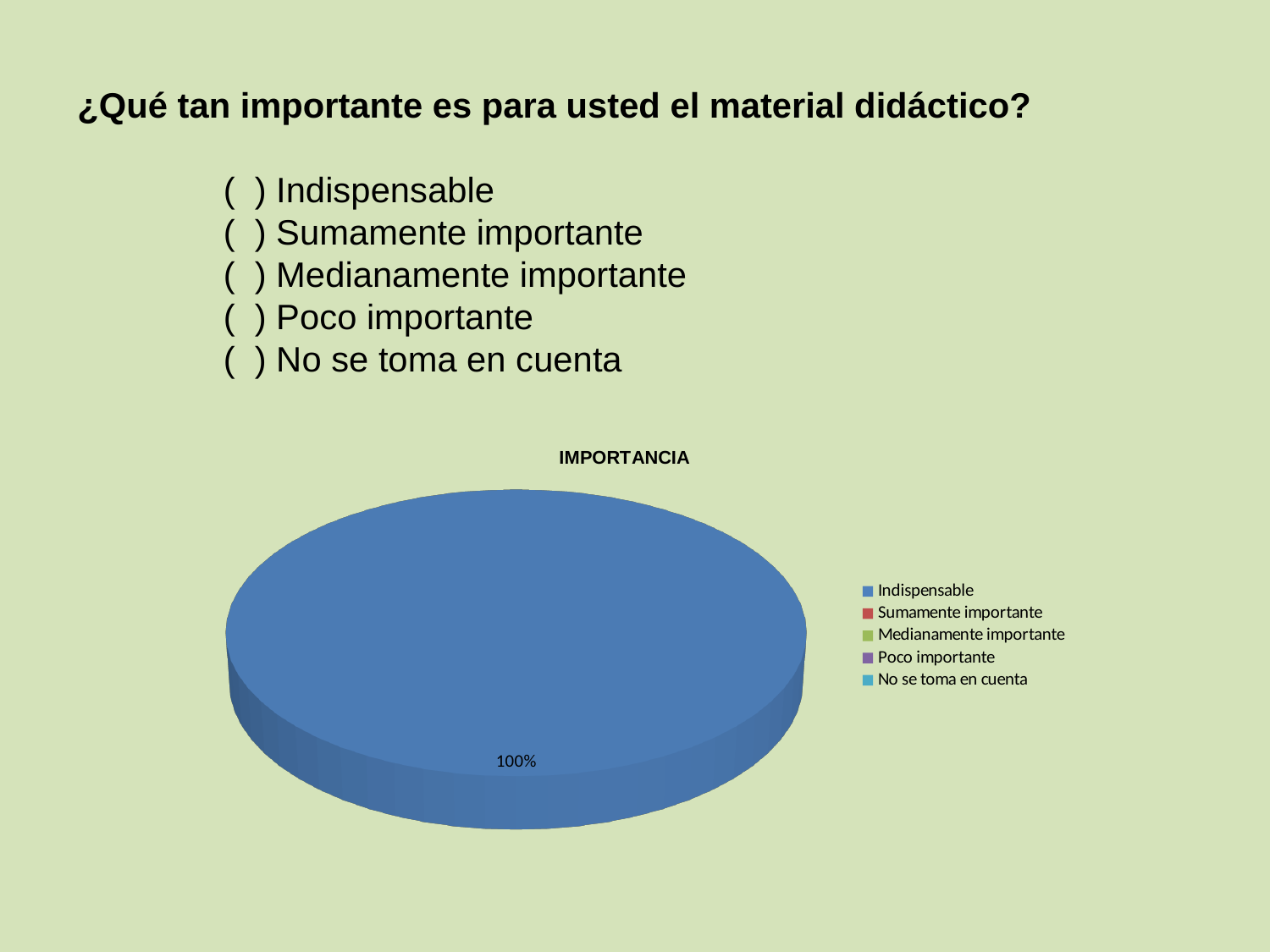
Is the share for Indispensable greater or less than 50%? greater What share of the pie does Indispensable take? 100% How many entries does the legend list? 5 What is the title of the chart? IMPORTANCIA Which category has the largest share of the pie? Indispensable What kind of chart is shown on the slide? pie chart What colour is the Indispensable slice? blue How many slices are visible in the pie? 1